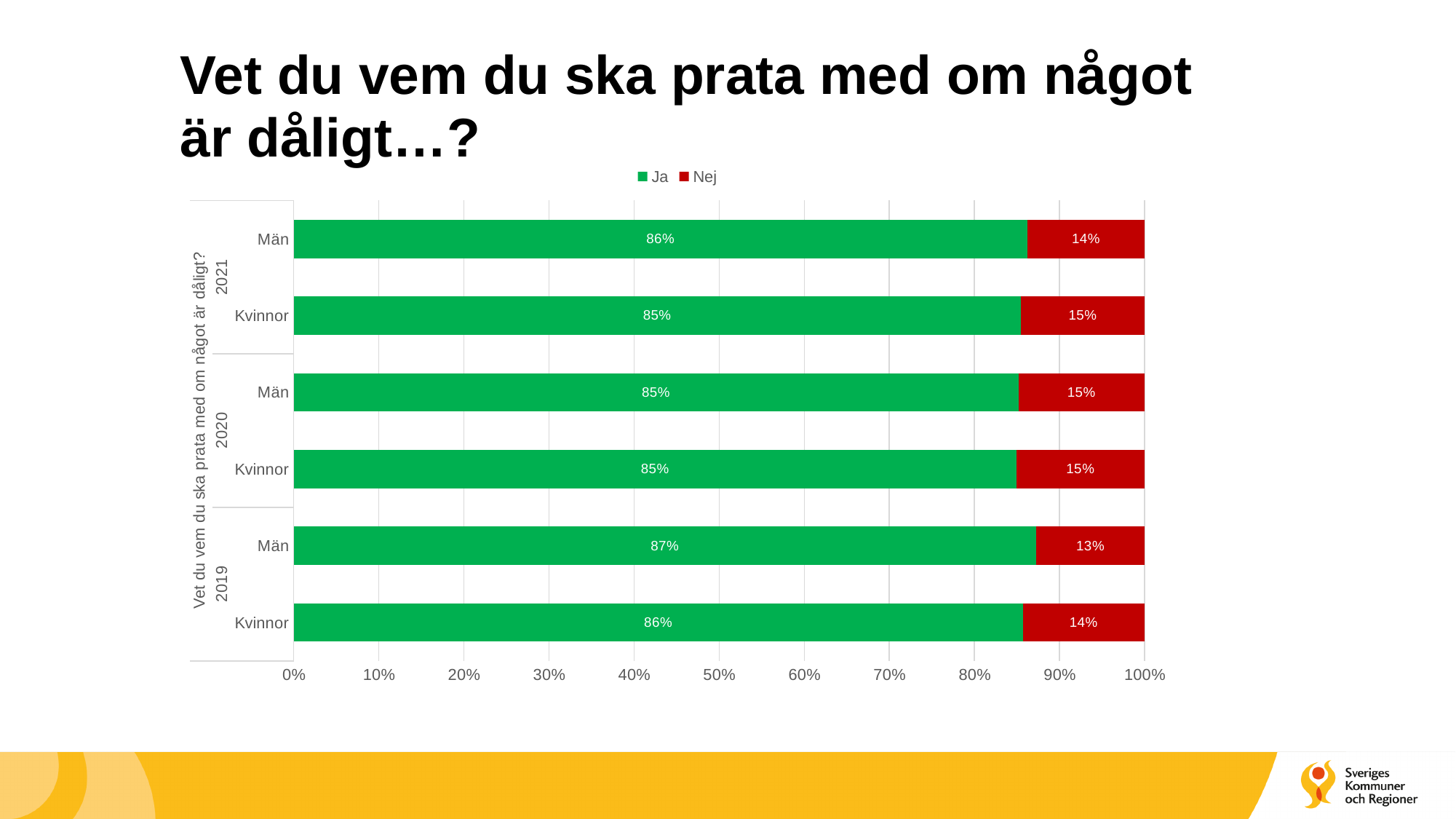
Which is larger: the Ja share for men (Män) in 2021 or for women (Kvinnor) in 2021? Män 2021 Which group and year has the highest share of Ja answers? Män 2019 What percentage of women (Kvinnor) answered Ja in 2021? 85% What percentage of men (Män) answered Nej in 2020? 15% What kind of chart is shown on the slide? Stacked bar chart What percentage of women (Kvinnor) answered Nej in 2019? 14% Which group and year has the lowest share of Nej answers? Män 2019 Which colour represents the Nej answers in the chart? Red What percentage of men (Män) answered Ja in 2021? 86% How many series does the legend list? 2 What is the difference in Ja share between men (Män) in 2019 and men (Män) in 2020? 2% How many bars are shown in the chart? 6